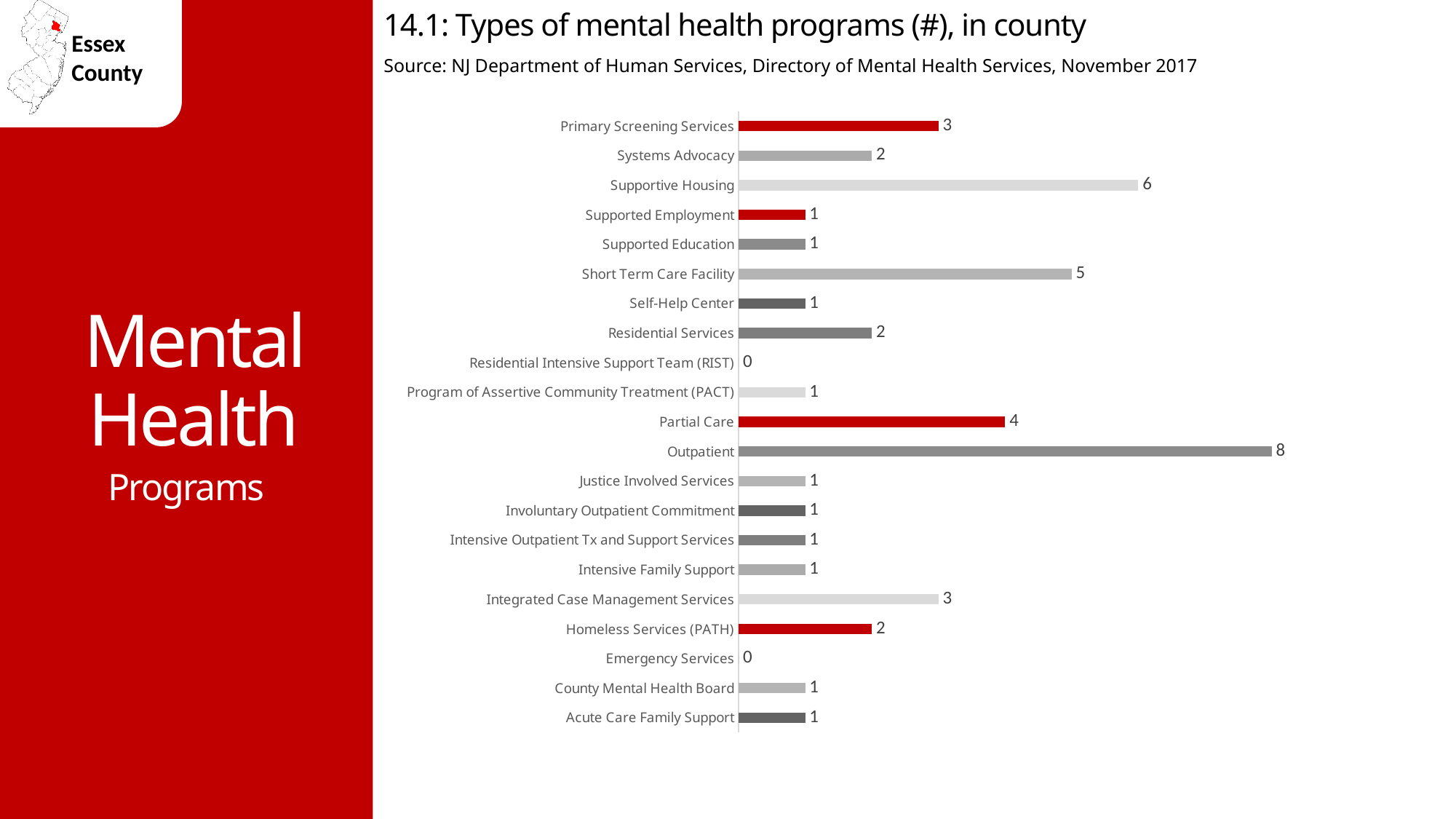
What is the value for Homeless Services (PATH)? 2 What is the difference between the number of Outpatient programs and Supportive Housing programs? 2 How many Outpatient programs are there in the county? 8 Which program type has the highest number of programs? Outpatient What is the value for Short Term Care Facility? 5 How many program types have a value of 0? 2 Which has more programs, Primary Screening Services or Systems Advocacy? Primary Screening Services What is the value for Supportive Housing? 6 How many program types (categories) are listed in the chart? 21 What is the title of the chart? 14.1: Types of mental health programs (#), in county What type of chart is shown on the slide? Bar chart What is the value for Partial Care? 4